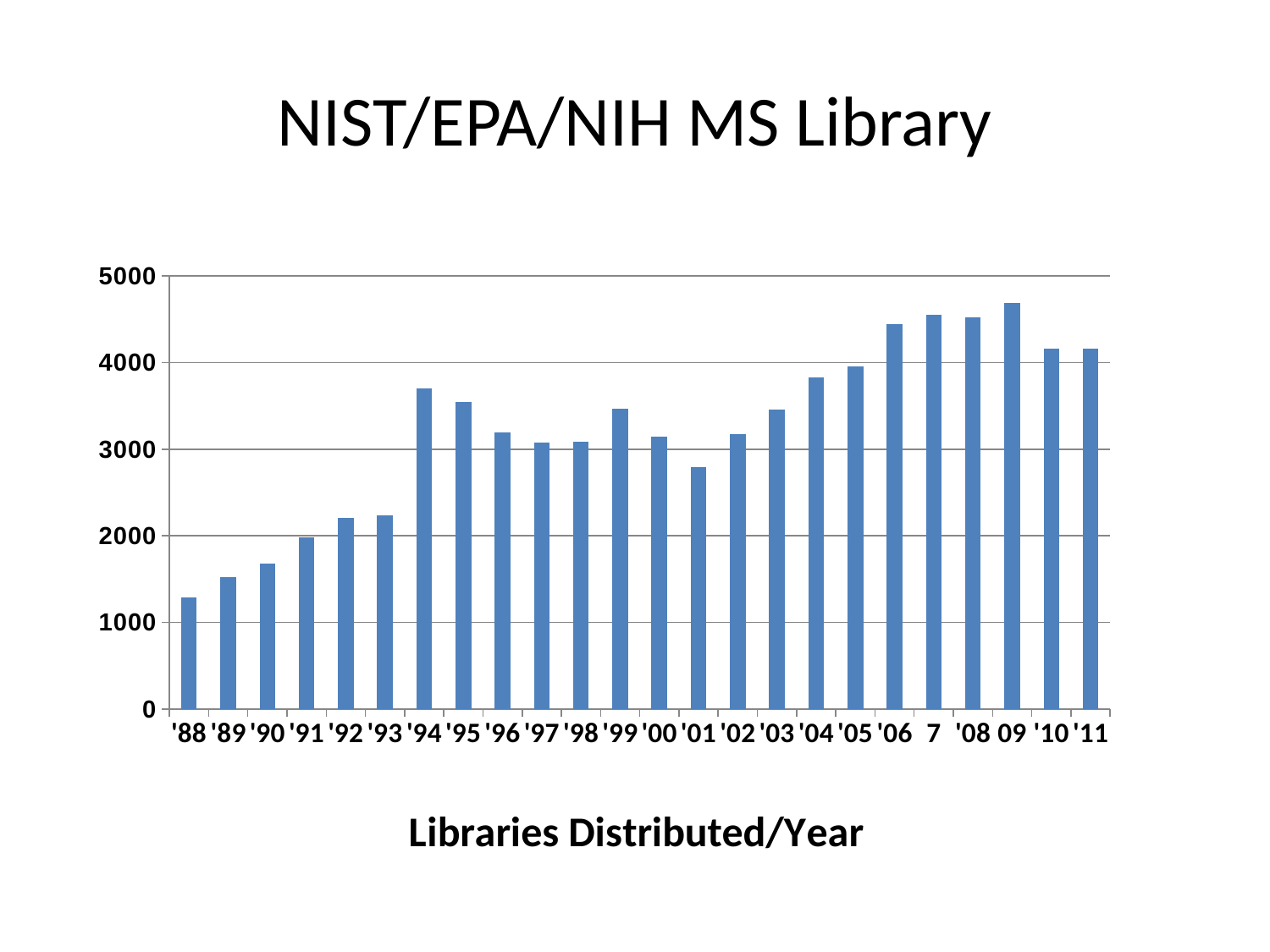
Do the values rise or fall from '88 to '94? rise What kind of chart is shown on the slide? bar chart Is the value for '06 greater or less than 4000? greater Is the value for '01 greater or less than 3000? less Which year has the highest number of libraries distributed? 09 Which year has the larger value, '94 or '95? '94 Is the value for '94 greater or less than 3000? greater Which year has the larger value, '01 or '02? '02 What is the label shown below the x axis of the chart? Libraries Distributed/Year Which year has the lowest number of libraries distributed? '88 How many years (bars) are plotted in the chart? 24